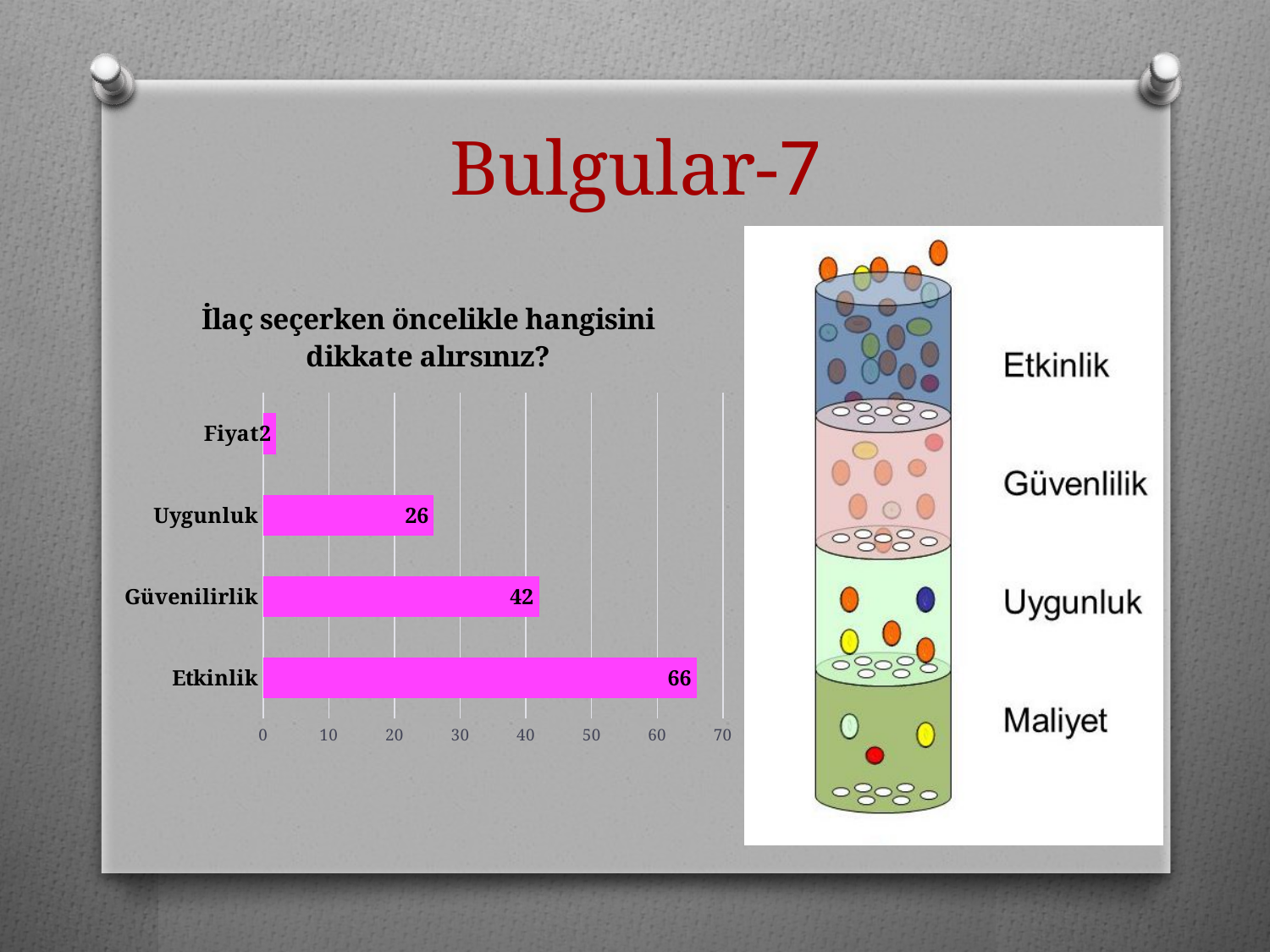
Which is larger, the value for Güvenilirlik or the value for Uygunluk? Güvenilirlik What is the difference between the values for Etkinlik and Güvenilirlik? 24 What is the difference between the values for Uygunluk and Fiyat? 24 Which category has the lowest value? Fiyat Which category has the highest value? Etkinlik What is the value for Güvenilirlik? 42 What kind of chart is shown on the slide? Bar chart How many categories are shown in the chart? 4 What is the value for Fiyat? 2 What is the value for Etkinlik? 66 What is the value for Uygunluk? 26 What is the title of the chart? İlaç seçerken öncelikle hangisini dikkate alırsınız?